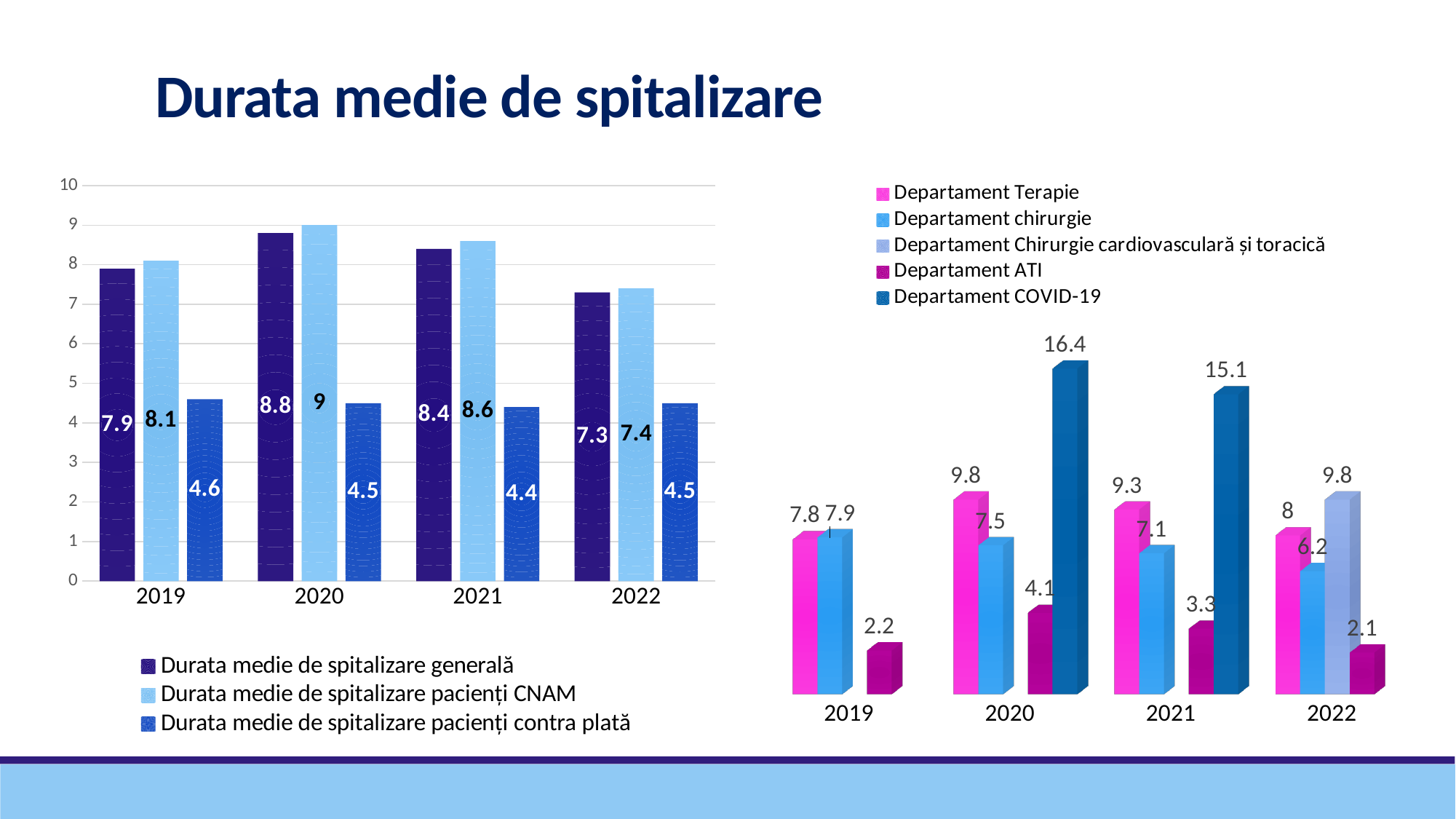
What kind of chart is the right chart? bar chart In the left chart, what is the difference between 'Durata medie de spitalizare pacienți CNAM' and 'Durata medie de spitalizare generală' in 2019? 0.2 In the left chart, does 'Durata medie de spitalizare generală' rise or fall from 2021 to 2022? fall In the left chart, how many series does the legend list? 3 In the left chart, which year has the highest value for 'Durata medie de spitalizare pacienți CNAM'? 2020 In the right chart, what is the difference between 'Departament COVID-19' in 2020 and in 2021? 1.3 In the right chart, what is the value for 'Departament Chirurgie cardiovasculară și toracică' in 2022? 9.8 In the right chart, which year has the lowest value for 'Departament ATI'? 2022 In the right chart, which is larger in 2021: 'Departament Terapie' or 'Departament chirurgie'? Departament Terapie In the left chart, what is the value of 'Durata medie de spitalizare generală' for 2020? 8.8 In the right chart, what is the value for 'Departament COVID-19' in 2020? 16.4 In the left chart, what is the value of 'Durata medie de spitalizare pacienți contra plată' for 2021? 4.4